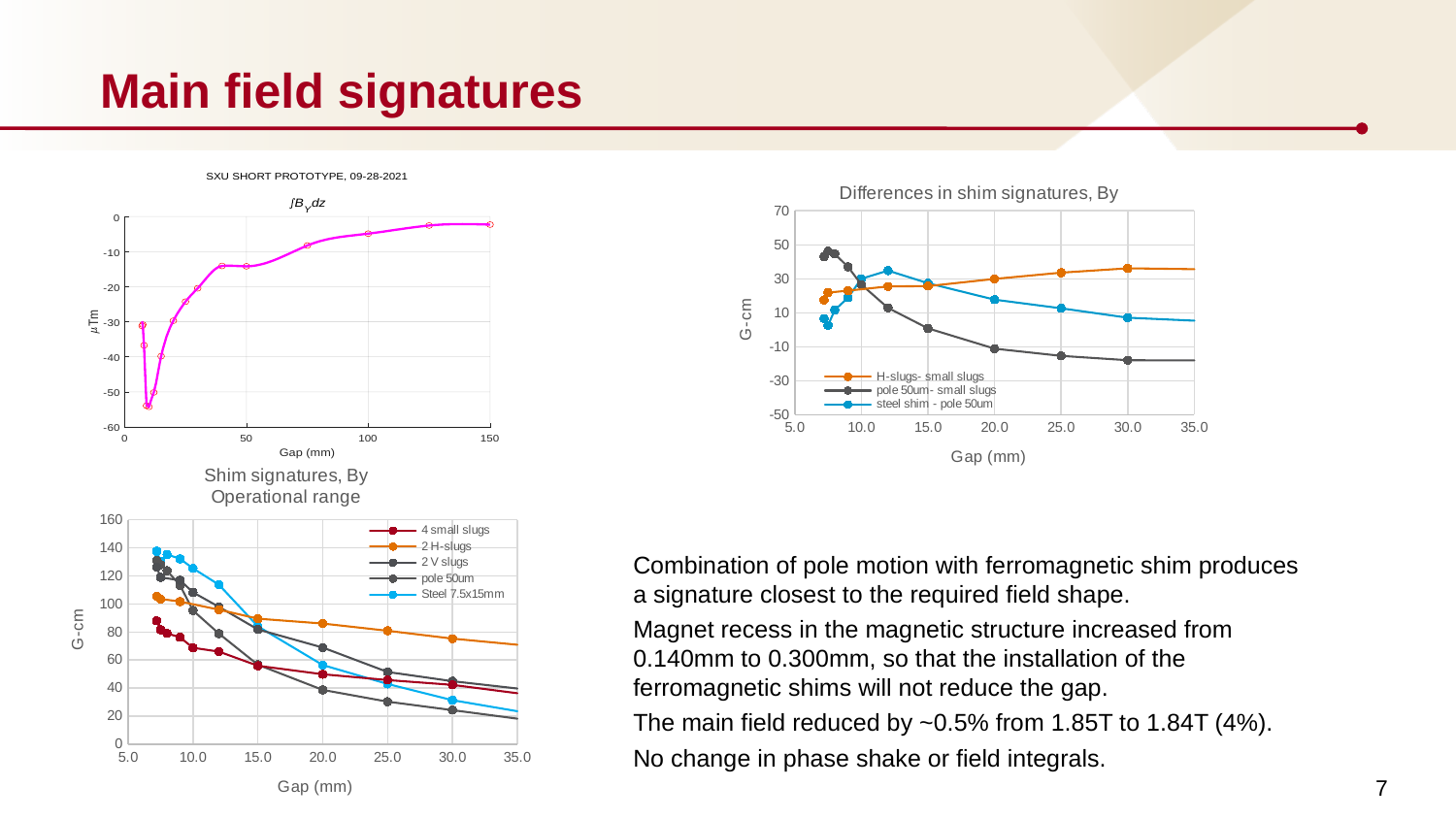
In the 'Differences in shim signatures, By' chart, how many series does the legend list? 3 In the 'Shim signatures, By Operational range' chart, do the values for '2 H-slugs' rise or fall as the gap increases? Fall How many charts are shown on the slide? 3 In the 'Shim signatures, By Operational range' chart, how many series does the legend list? 5 In the 'Shim signatures, By Operational range' chart, which series has the highest value at a gap of 30.0 mm? 2 H-slugs In the 'Differences in shim signatures, By' chart, do the values for 'H-slugs- small slugs' rise or fall as the gap increases from 10.0 to 35.0 mm? Rise What is the y-axis label of the 'SXU SHORT PROTOTYPE, 09-28-2021' chart? μTm In the 'Differences in shim signatures, By' chart, which series has the lowest value at a gap of 35.0 mm? pole 50um- small slugs What kind of chart is the 'Shim signatures, By Operational range' chart? Line chart In the 'Shim signatures, By Operational range' chart, at a gap of 20.0 mm, which is larger: '2 H-slugs' or '4 small slugs'? 2 H-slugs